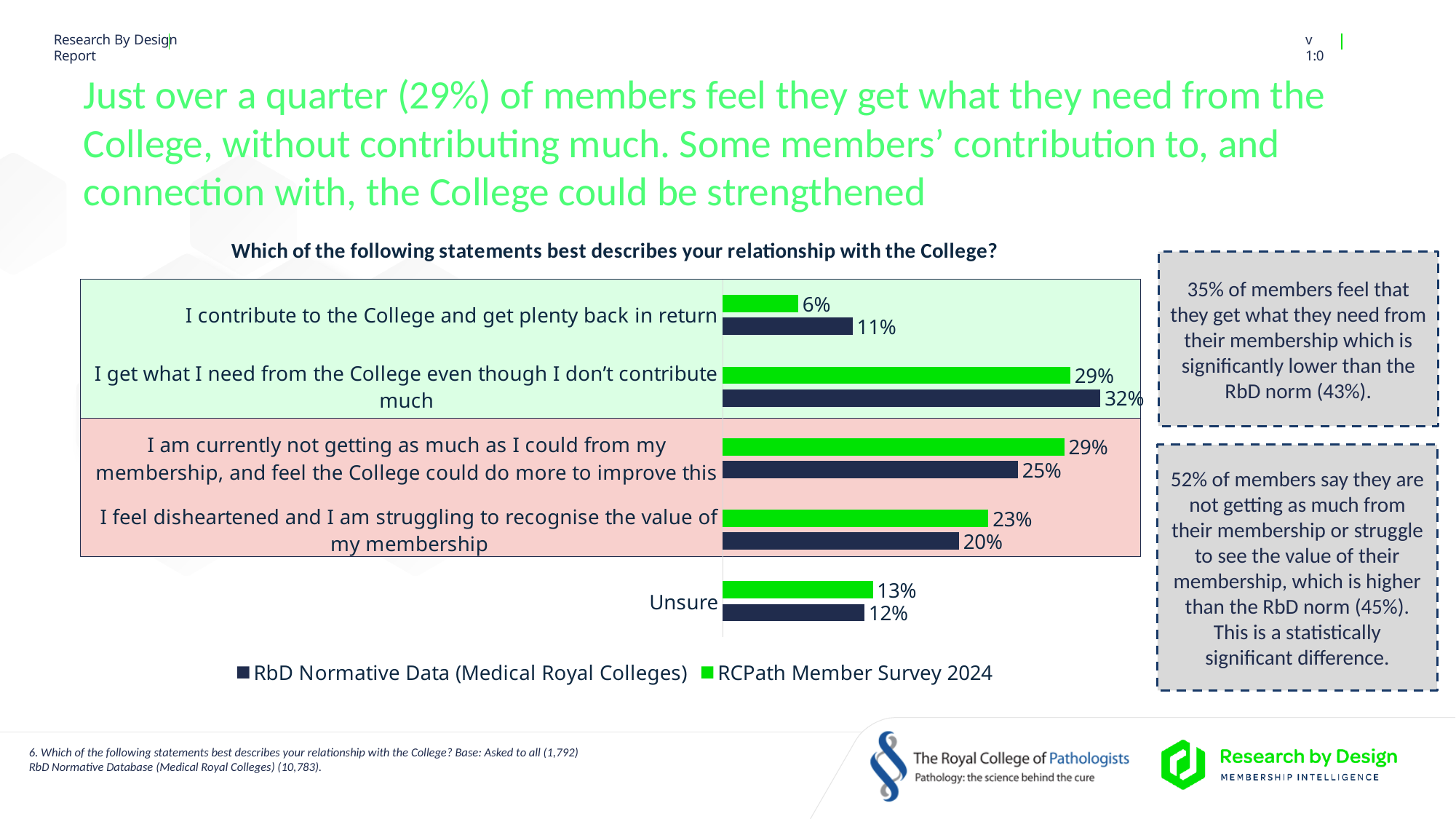
What colour are the RCPath Member Survey 2024 bars? Green How many series does the legend list? 2 Which statement has the lowest value in the RbD Normative Data series? I contribute to the College and get plenty back in return What is the RbD Normative Data value for 'I get what I need from the College even though I don't contribute much'? 32% What percentage of RCPath Member Survey 2024 respondents chose 'Unsure'? 13% What is the difference between the RbD Normative Data and RCPath Member Survey 2024 values for 'I contribute to the College and get plenty back in return'? 5 percentage points What is the difference between the RCPath Member Survey 2024 and RbD Normative Data values for 'I am currently not getting as much as I could from my membership, and feel the College could do more to improve this'? 4 percentage points How many statement categories are shown in the chart? 5 What type of chart is shown on the slide? Bar chart For 'I feel disheartened and I am struggling to recognise the value of my membership', which series has the larger value? RCPath Member Survey 2024 Which statement has the highest value in the RCPath Member Survey 2024 series? I get what I need from the College even though I don't contribute much / I am currently not getting as much as I could from my membership, and feel the College could do more to improve this (both 29%) What percentage of RCPath Member Survey 2024 respondents said 'I contribute to the College and get plenty back in return'? 6%